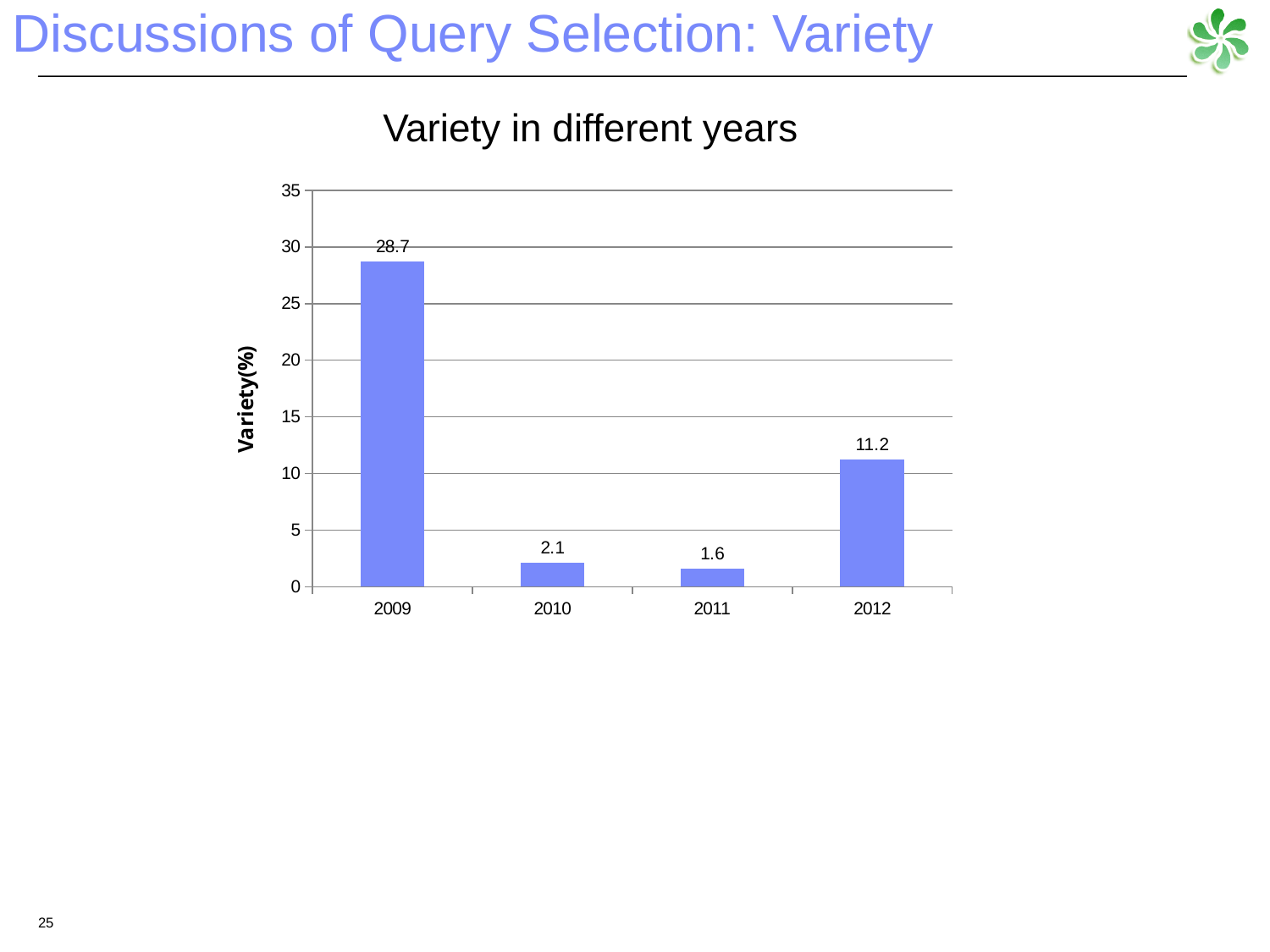
Which year has the lowest variety value? 2011 Which year has a larger variety value, 2010 or 2012? 2012 What kind of chart is shown on the slide? Bar chart What is the difference between the variety values for 2010 and 2011? 0.5 What is the variety value for 2012? 11.2 What is the variety value for 2011? 1.6 What is the variety value for 2010? 2.1 What is the variety value for 2009? 28.7 What is the difference between the variety values for 2009 and 2012? 17.5 Which year has the highest variety value? 2009 What is the title of the chart? Variety in different years How many years are shown on the x axis? 4